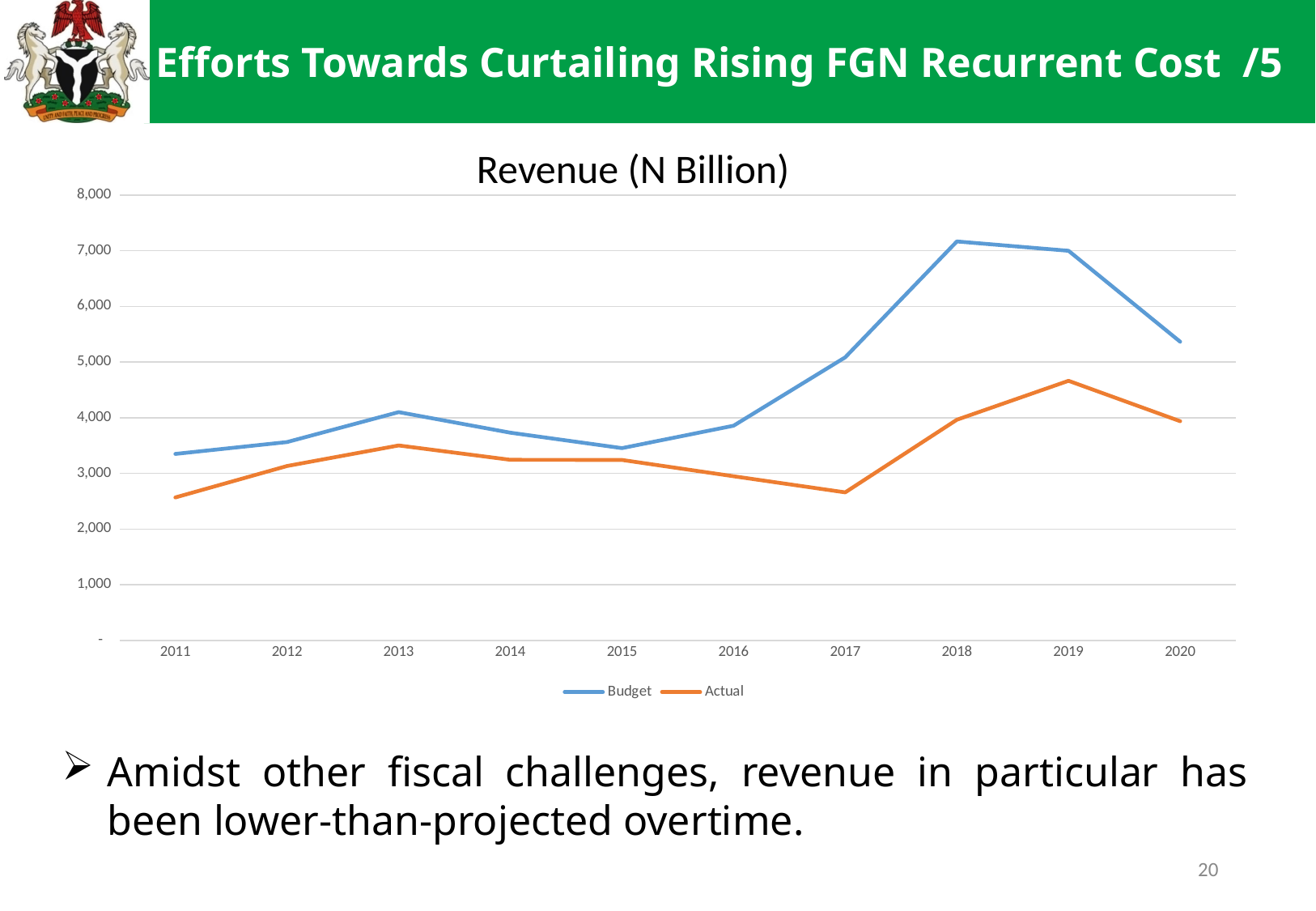
Does the Budget series rise or fall between 2016 and 2018? Rise What kind of chart is shown on the slide? Line chart In which year does the Budget series reach its highest value? 2018 Is the Actual value for 2011 greater or less than 3,000? less How many years are plotted along the x axis? 10 How many series does the legend list? 2 Is the Budget value for 2018 greater or less than 7,000? greater In 2018, which series has the larger value, Budget or Actual? Budget Is the Budget value for 2020 greater or less than 5,000? greater In which year does the Actual series reach its highest value? 2019 What is the title of the chart? Revenue (N Billion)